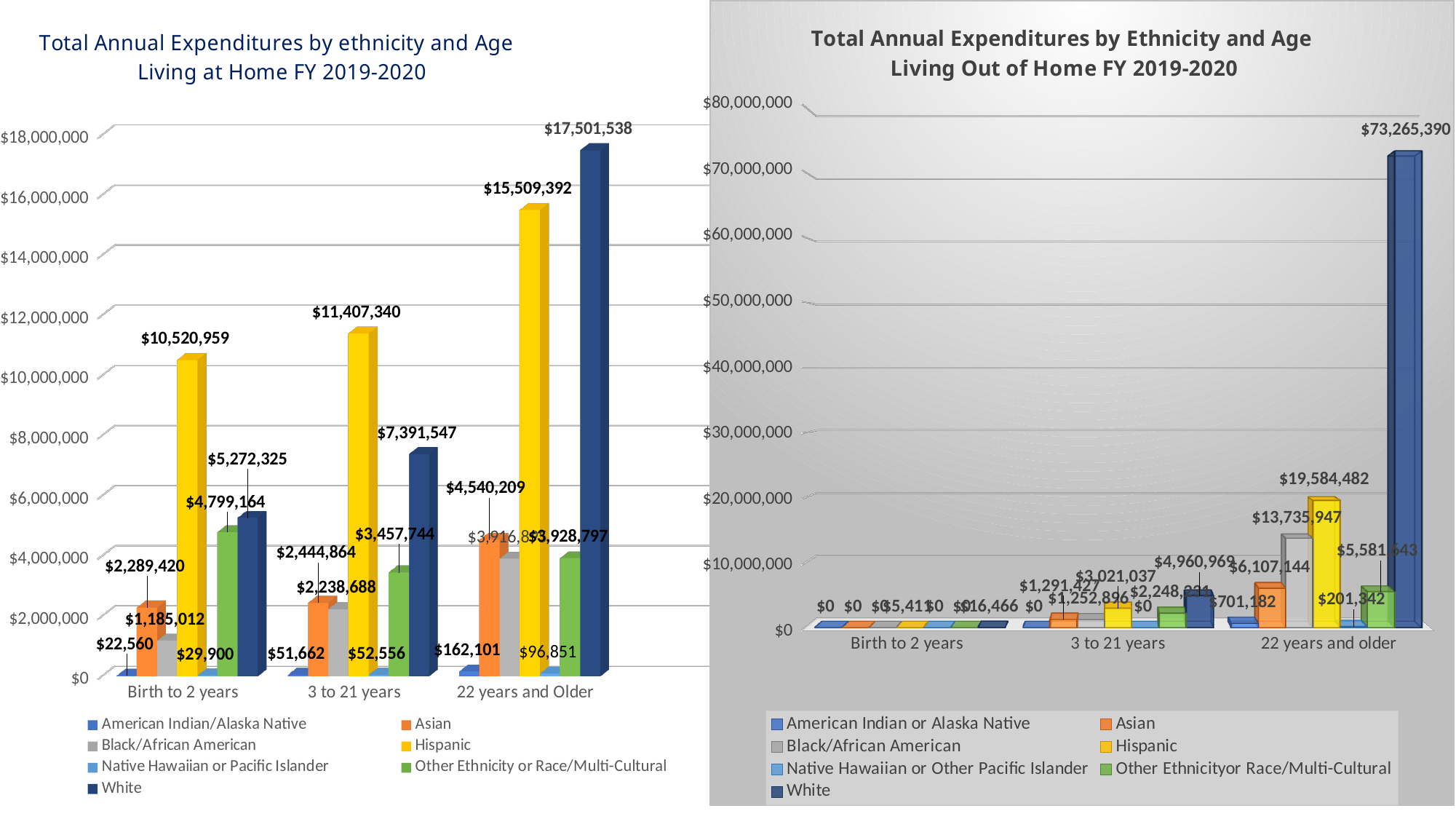
In the 'Living Out of Home' chart, is the value for White in the 22 years and older category greater or less than $70,000,000? greater How many series does the legend of the 'Living at Home' chart list? 7 In the 'Living Out of Home' chart, what is the value for Hispanic in the 22 years and older category? $19,584,482 In the 'Living Out of Home' chart, which is larger in the 22 years and older category: Black/African American or Asian? Black/African American What kind of chart is the 'Living Out of Home' chart? Bar chart In the 'Living at Home' chart, which ethnicity has the highest value in the 3 to 21 years category? Hispanic In the 'Living Out of Home' chart, what is the value for White in the 22 years and older category? $73,265,390 In the 'Living at Home' chart, which ethnicity has the lowest value in the Birth to 2 years category? American Indian/Alaska Native In the 'Living at Home' chart, what is the difference between the White and Hispanic values in the 22 years and Older category? $1,992,146 In the 'Living at Home' chart, what is the value for Asian in the 3 to 21 years category? $2,444,864 In the 'Living at Home' chart, what is the value for White in the 22 years and Older category? $17,501,538 In the 'Living at Home' chart, what is the value for Hispanic in the Birth to 2 years category? $10,520,959